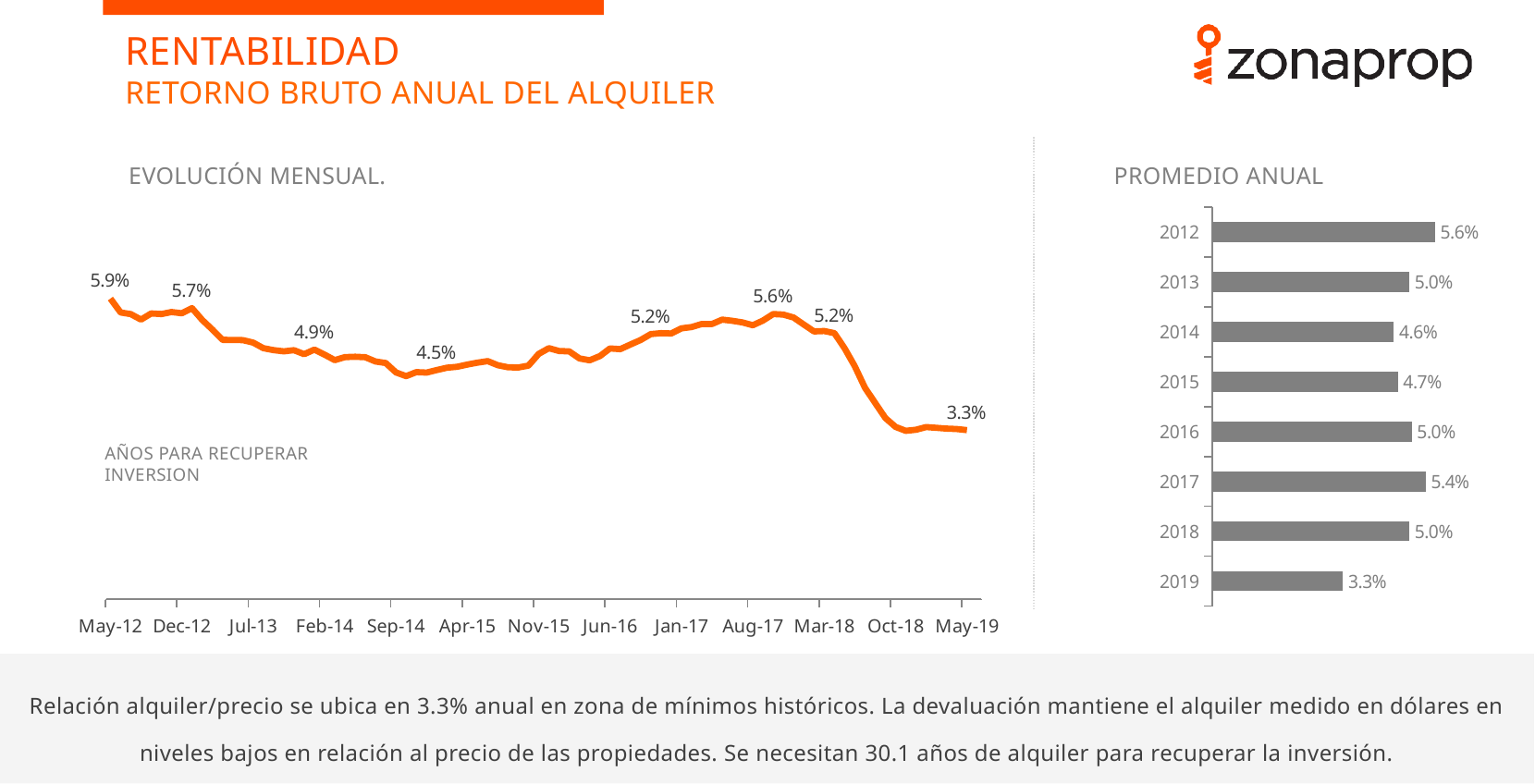
What kind of chart is the EVOLUCIÓN MENSUAL chart? Line chart In the PROMEDIO ANUAL chart, what is the value for 2014? 4.6% In the PROMEDIO ANUAL chart, what is the difference between the values for 2012 and 2019? 2.3% In the PROMEDIO ANUAL chart, what is the value for 2019? 3.3% In the EVOLUCIÓN MENSUAL chart, what is the value at May-19? 3.3% How many years are shown in the PROMEDIO ANUAL chart? 8 In the PROMEDIO ANUAL chart, which year has the lowest value? 2019 In the PROMEDIO ANUAL chart, which year has the highest value? 2012 What kind of chart is the PROMEDIO ANUAL chart? Bar chart In the PROMEDIO ANUAL chart, which is larger, the value for 2017 or the value for 2015? 2017 In the EVOLUCIÓN MENSUAL chart, what is the value at May-12? 5.9% In the PROMEDIO ANUAL chart, what is the value for 2012? 5.6%